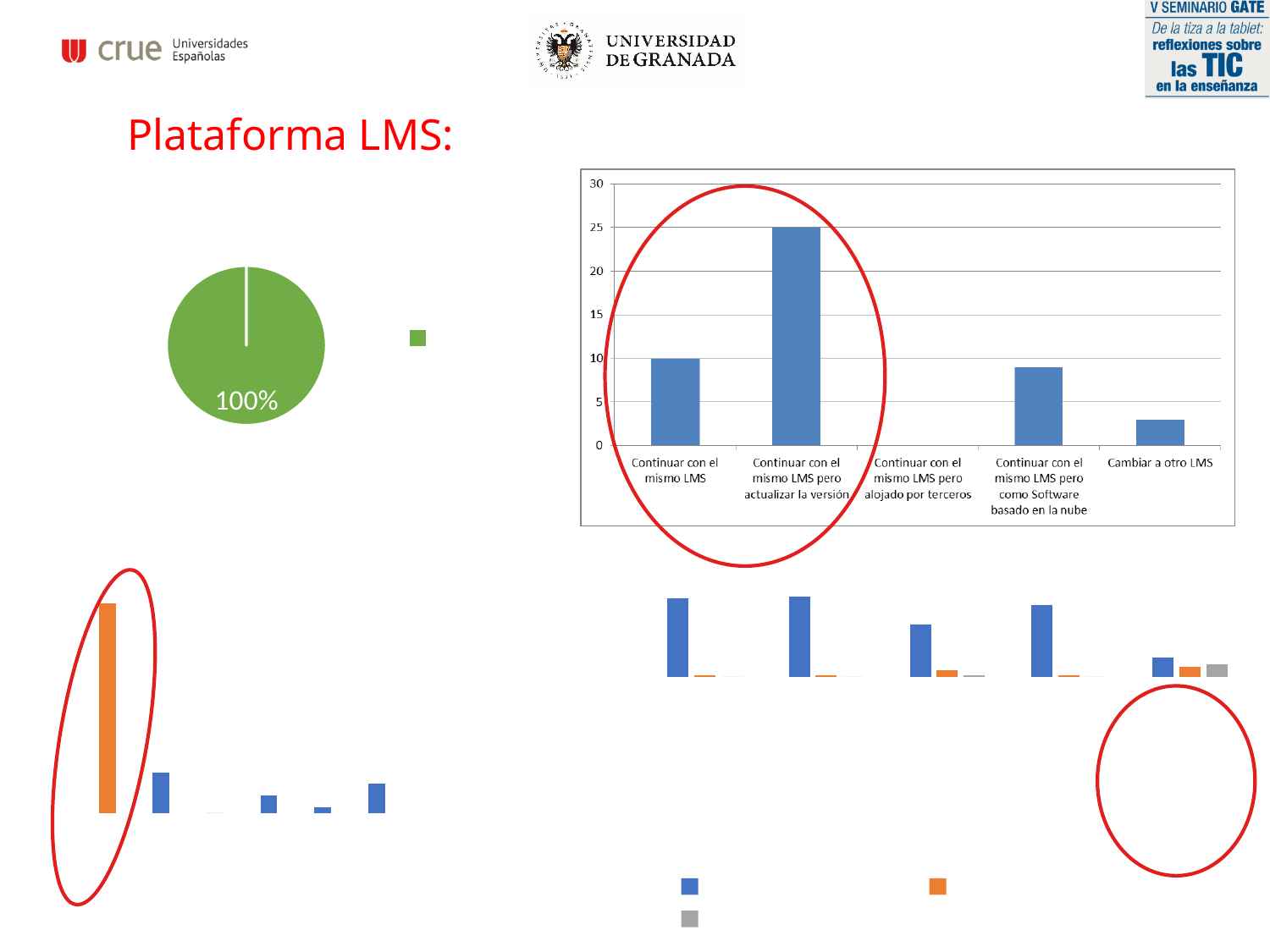
In the pie chart on the left, what share is shown on the green slice? 100% In the bar chart at the top right, what is the value for "Continuar con el mismo LMS"? 10 In the bar chart at the top right, what is the difference between the value for "Continuar con el mismo LMS pero actualizar la versión" and the value for "Continuar con el mismo LMS"? 15 In the bar chart at the top right, which category has the lowest value? Continuar con el mismo LMS pero alojado por terceros In the bar chart at the top right, what is the value for "Continuar con el mismo LMS pero actualizar la versión"? 25 What kind of chart is the chart at the top right of the slide? bar chart In the bar chart at the top right, is the value for "Continuar con el mismo LMS pero como Software basado en la nube" greater or less than 10? less In the bar chart at the top right, is the value for "Cambiar a otro LMS" greater or less than 5? less In the bar chart at the top right, how many categories are shown on the x axis? 5 What kind of chart is the green chart on the left of the slide? pie chart In the bar chart at the top right, which is larger: the value for "Continuar con el mismo LMS" or the value for "Cambiar a otro LMS"? Continuar con el mismo LMS In the bar chart at the top right, which category has the highest value? Continuar con el mismo LMS pero actualizar la versión